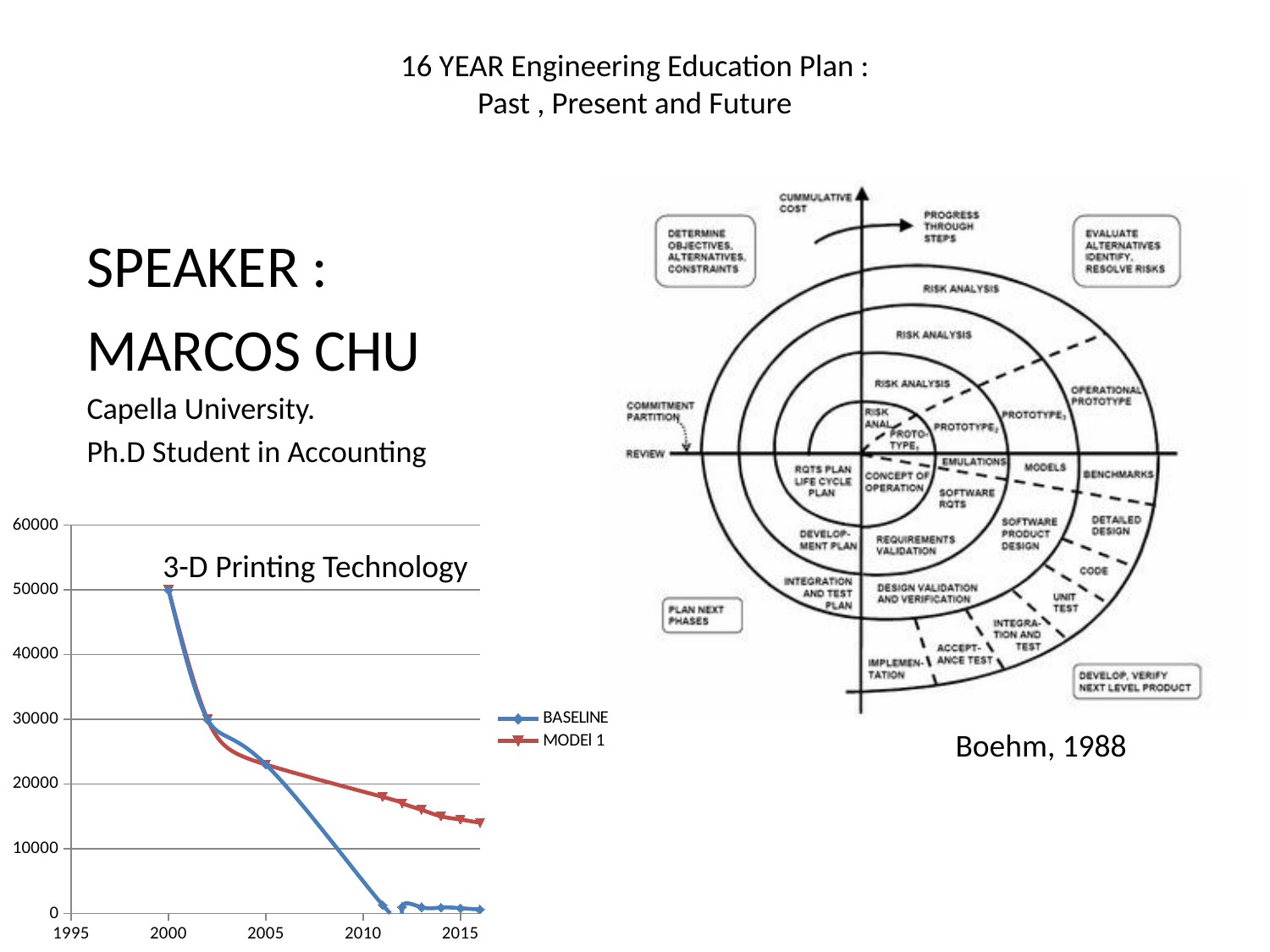
In the "3-D Printing Technology" chart, which series has the lower value at 2010? BASELINE In the "3-D Printing Technology" chart, is the BASELINE value at 2005 greater or less than 20000? greater In the "3-D Printing Technology" chart, do the BASELINE values rise or fall from 2000 to 2015? Fall What is the title of the line chart on the slide? 3-D Printing Technology How many series does the legend of the "3-D Printing Technology" chart list? 2 In the "3-D Printing Technology" chart, which series has the larger value at 2015, BASELINE or MODEl 1? MODEl 1 What kind of chart is the "3-D Printing Technology" chart? Line chart In the "3-D Printing Technology" chart, is the BASELINE value at 2015 greater or less than 10000? less In the "3-D Printing Technology" chart, is the MODEl 1 value at 2015 greater or less than 10000? greater What are the two series named in the legend of the "3-D Printing Technology" chart? BASELINE and MODEl 1 In the "3-D Printing Technology" chart, do the MODEl 1 values rise or fall from 2000 to 2015? Fall